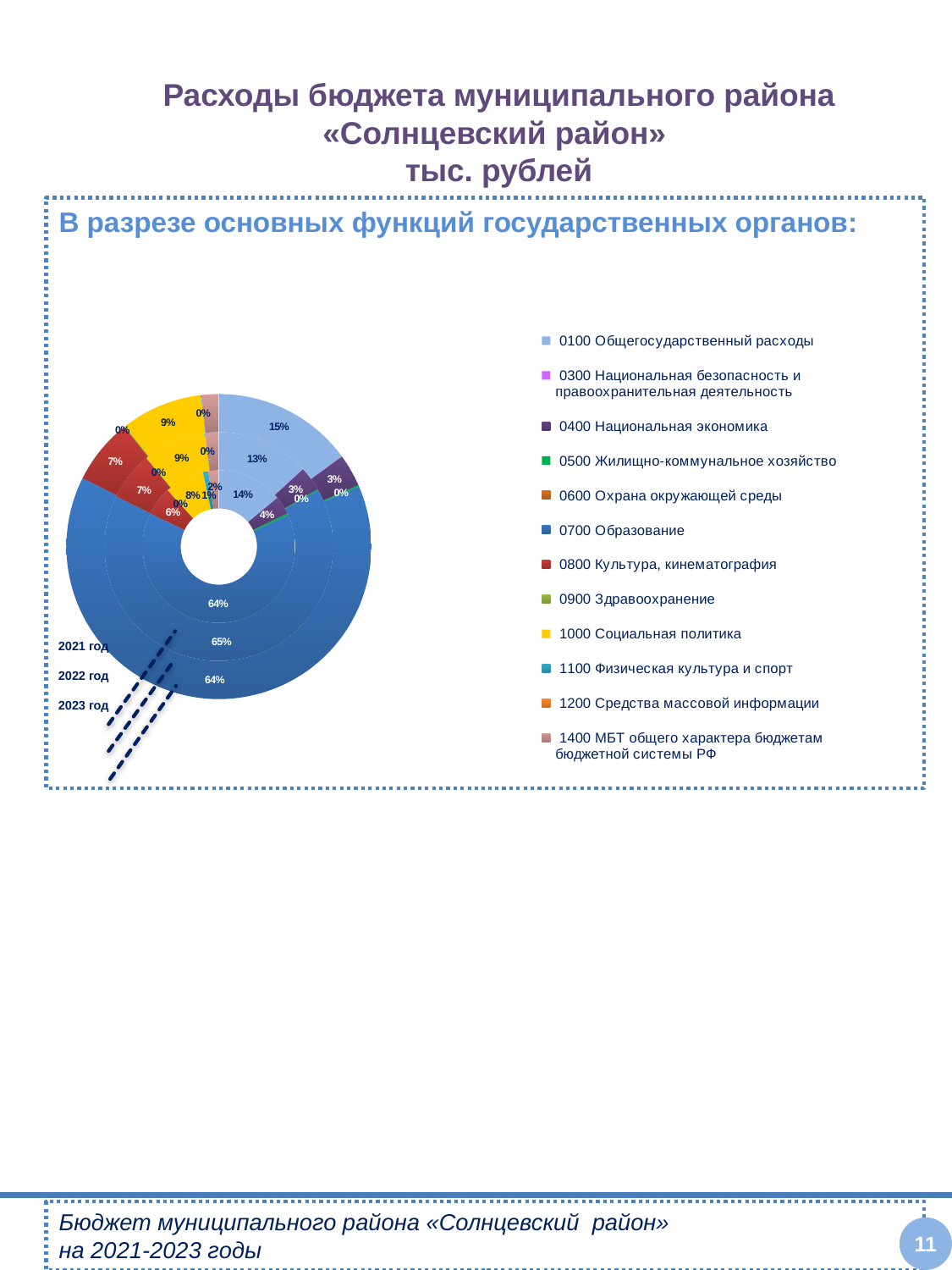
What share does 0100 Общегосударственные расходы have in the middle ring (2022 год)? 13% What kind of chart is shown on the slide? Doughnut (pie) chart How many categories does the chart legend list? 12 Which years are labelled on the chart? 2021 год, 2022 год, 2023 год What share does 0700 Образование have in the middle ring (2022 год)? 65% What share does 0100 Общегосударственные расходы have in the inner ring (2021 год)? 14% How many rings (years) does the doughnut chart have? 3 What is the difference between the share of 0700 Образование and the share of 0100 Общегосударственные расходы in the outer ring (2023 год)? 49% Which category has the largest share of expenditures in every ring of the chart? 0700 Образование Which is larger in the outer ring (2023 год): the share of 1000 Социальная политика or the share of 0800 Культура, кинематография? 1000 Социальная политика